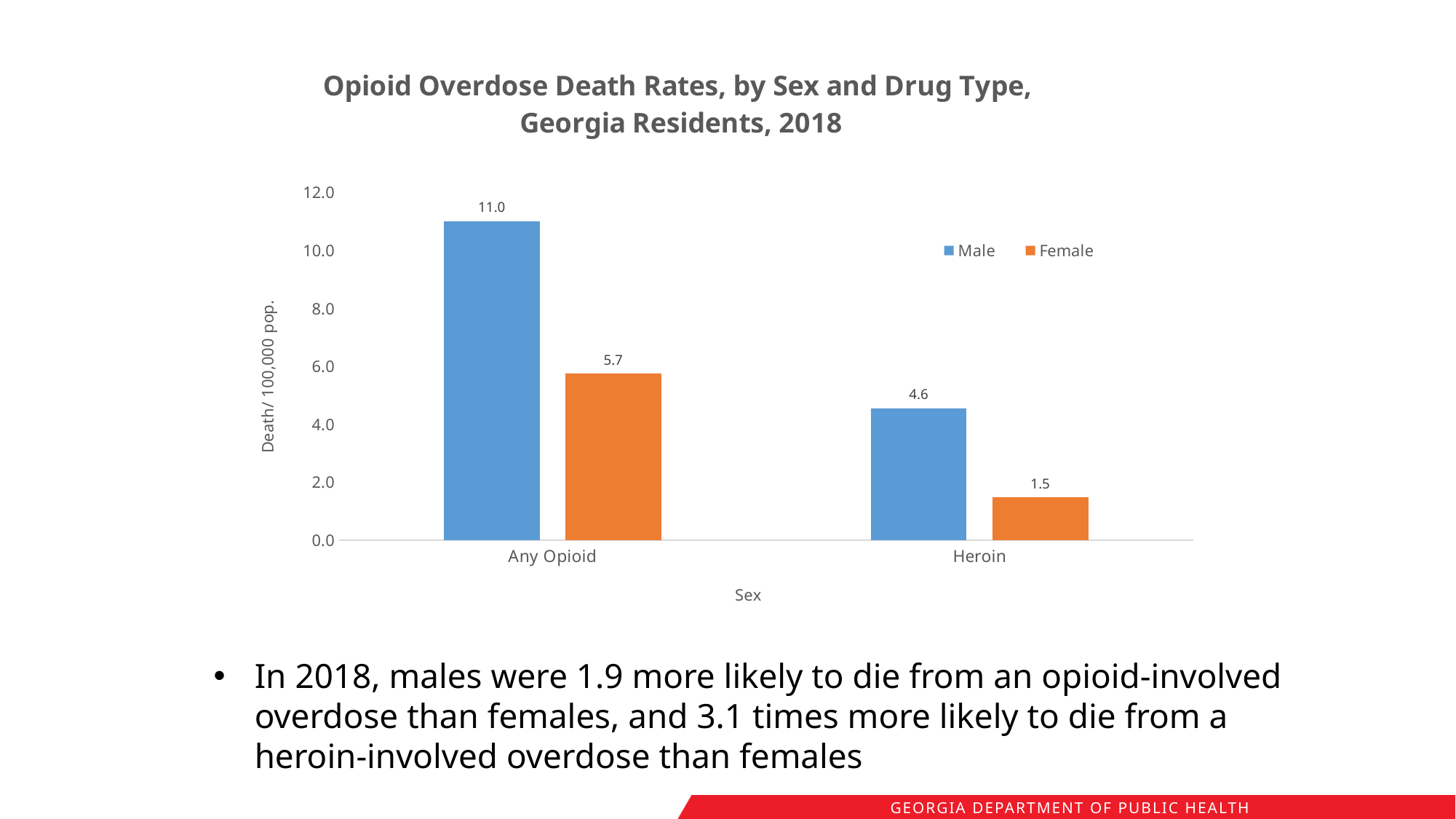
What is the difference between the Male and Female death rates for Heroin? 3.1 Which bar has the lowest value on the chart? Female, Heroin What is the label on the vertical axis? Death/ 100,000 pop. Which is larger, the Female rate for Any Opioid or the Male rate for Heroin? Female rate for Any Opioid What is the difference between the Male and Female death rates for Any Opioid? 5.3 How many series does the legend list? 2 What is the Female death rate for Any Opioid? 5.7 What is the Male death rate for Heroin? 4.6 What is the Female death rate for Heroin? 1.5 What kind of chart is shown on the slide? Bar chart What is the Male death rate for Any Opioid? 11.0 Which bar has the highest value on the chart? Male, Any Opioid